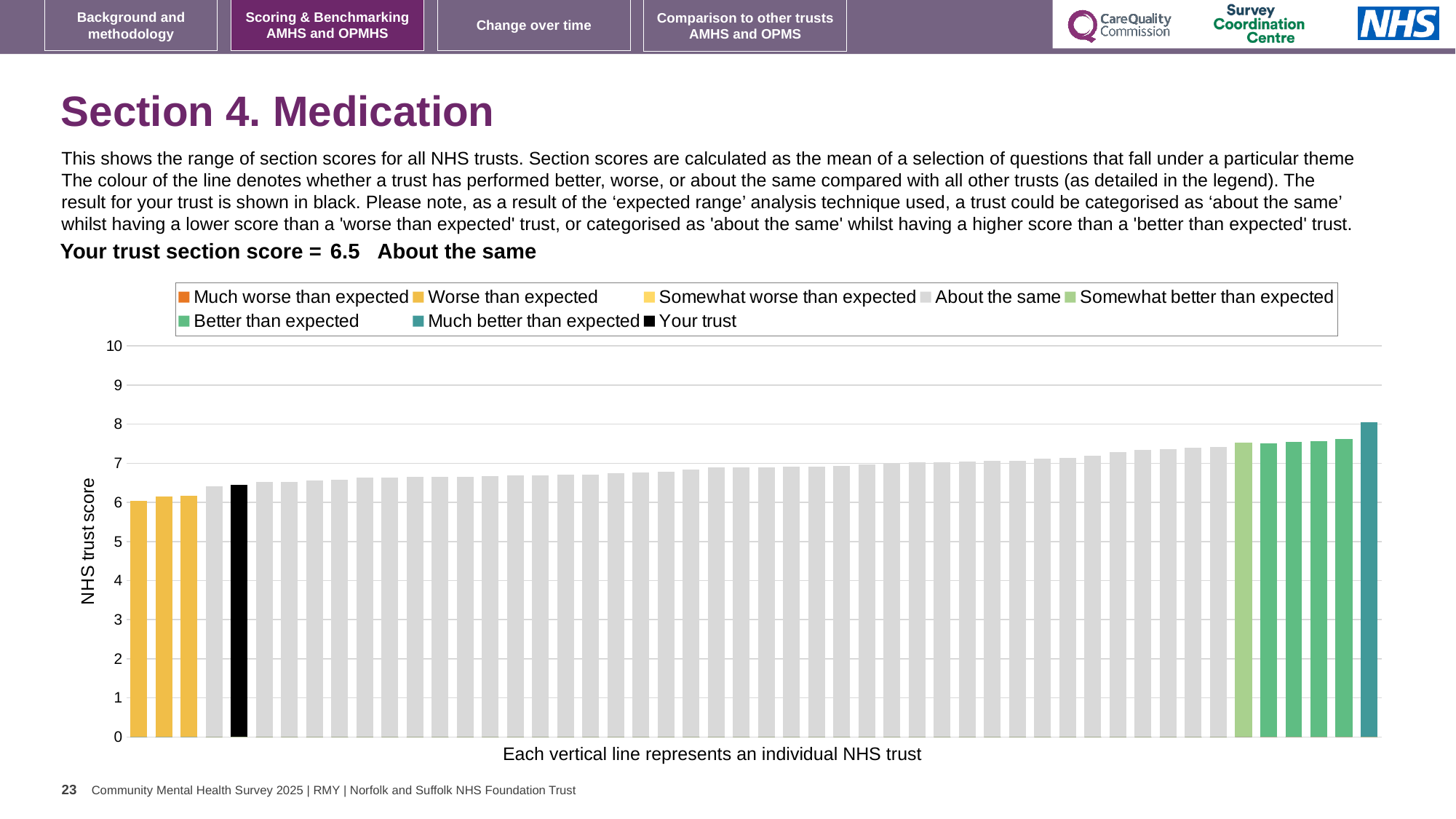
What kind of chart is shown on the slide? bar chart How many bars are coloured as 'Much better than expected'? 1 Do the bar values rise or fall from left to right along the x axis? rise Which category is your trust's section score placed in? About the same What is the section score for your trust shown on the slide? 6.5 What is the label on the vertical axis of the chart? NHS trust score Is the value of the shortest bar on the chart greater or less than 7? less Is the value of the tallest bar (the 'Much better than expected' trust) greater or less than 7? greater How many bars are coloured as 'Worse than expected'? 3 How many entries does the chart legend list? 8 What colour is used for the 'Your trust' bar? black Is the value of the black 'Your trust' bar greater or less than 5? greater